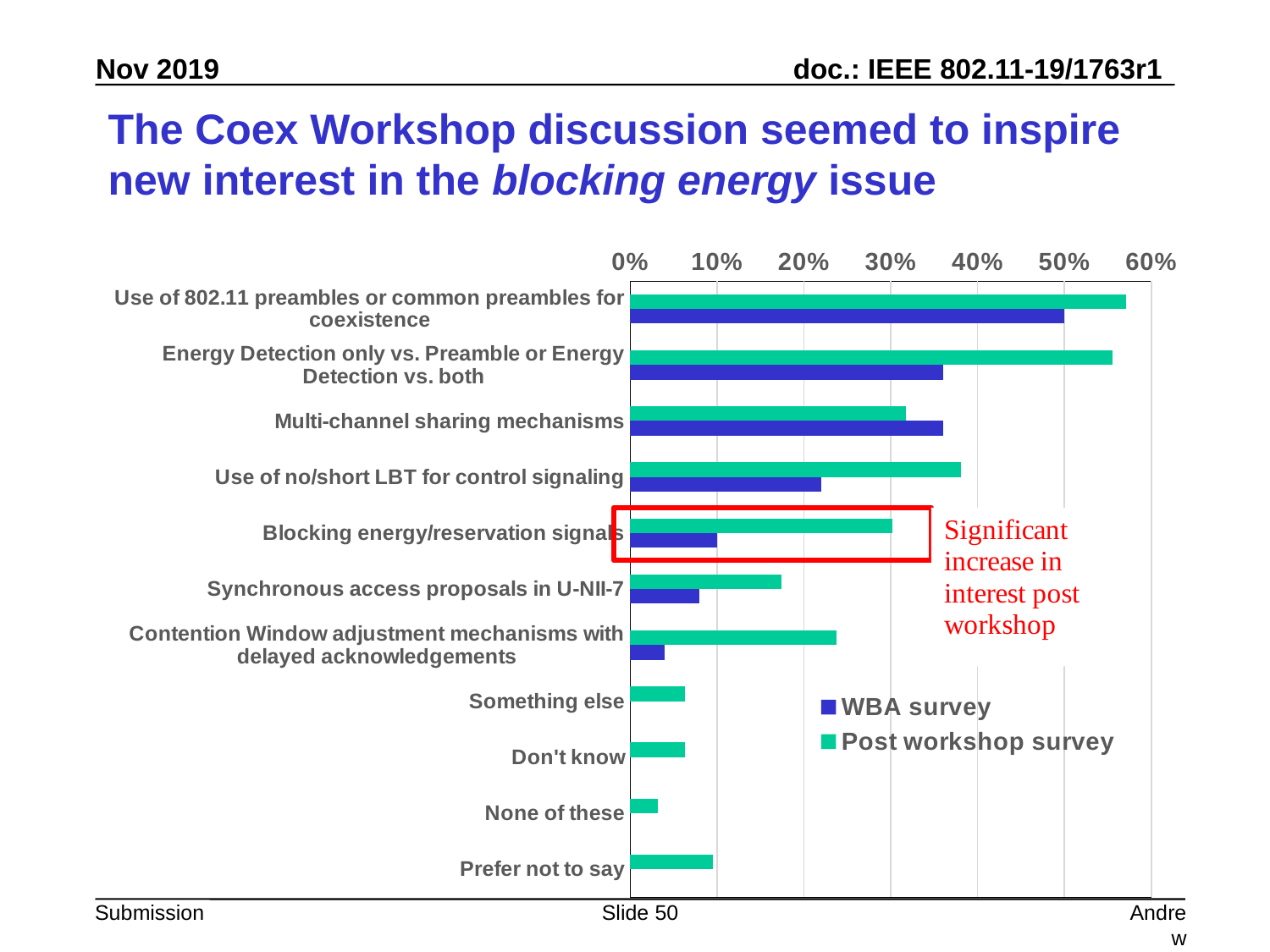
Is the Post workshop survey value for Blocking energy/reservation signals greater or less than 20%? greater How many categories are plotted on the chart? 11 What colour represents the Post workshop survey series in the chart? Green For Energy Detection only vs. Preamble or Energy Detection vs. both, which series has the larger value, WBA survey or Post workshop survey? Post workshop survey Is the WBA survey value for Blocking energy/reservation signals greater or less than 20%? less Which category has the lowest non-zero value for the Post workshop survey series? None of these What kind of chart is shown on the slide? Bar chart How many series does the legend list? 2 Which category has the highest value for the WBA survey series? Use of 802.11 preambles or common preambles for coexistence For Multi-channel sharing mechanisms, which series has the larger value, WBA survey or Post workshop survey? WBA survey Is the Post workshop survey value for Use of no/short LBT for control signaling greater or less than 30%? greater